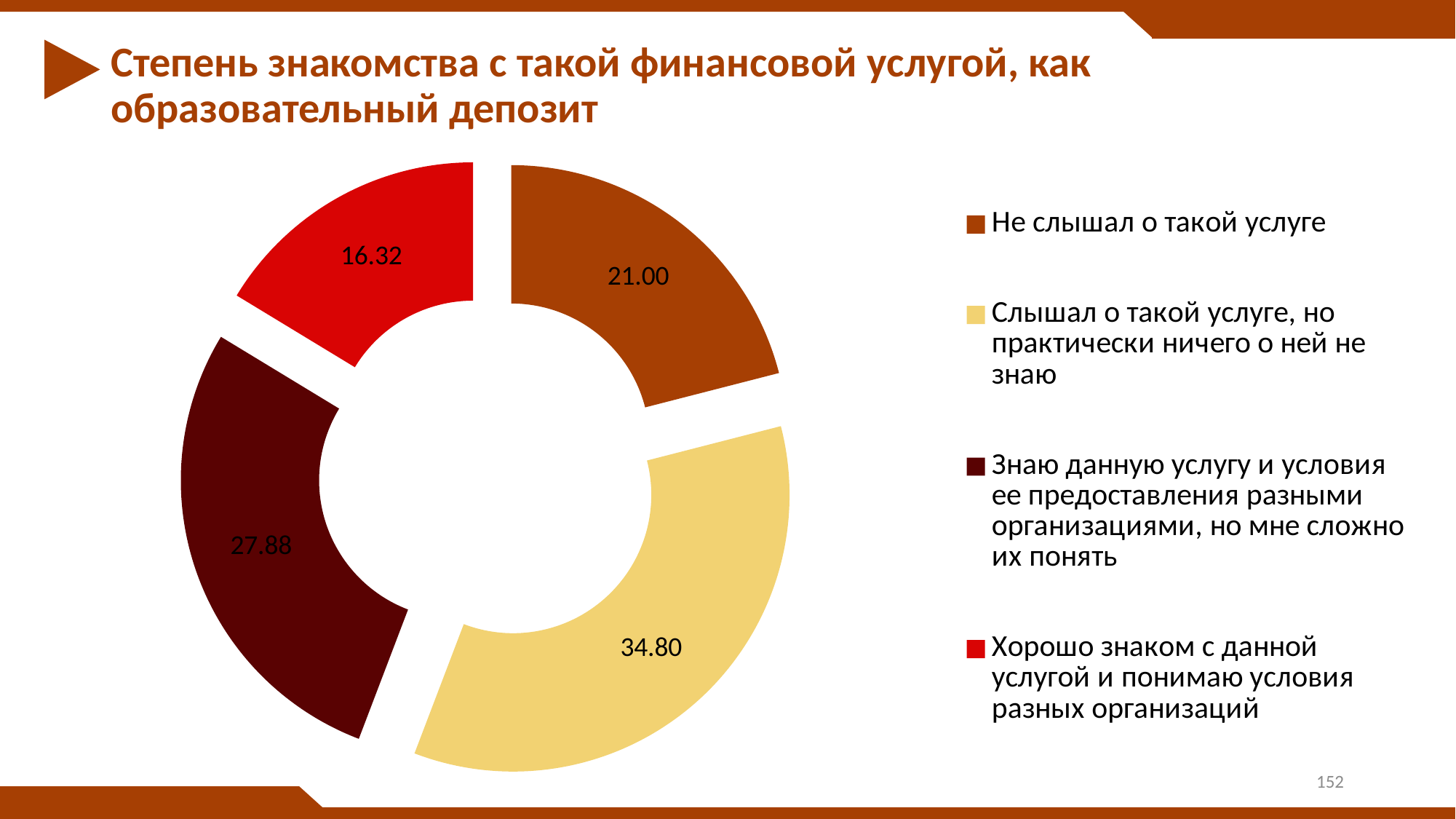
What kind of chart is shown on the slide? doughnut chart Which category has the largest slice? Слышал о такой услуге, но практически ничего о ней не знаю What is the total of all four slice values? 100.00 How many slices does the chart have? 4 Which is larger: the value for 'Не слышал о такой услуге' or the value for 'Хорошо знаком с данной услугой и понимаю условия разных организаций'? Не слышал о такой услуге What value is shown for the slice 'Слышал о такой услуге, но практически ничего о ней не знаю'? 34.80 What value is shown for the slice 'Хорошо знаком с данной услугой и понимаю условия разных организаций'? 16.32 What is the difference between the values for 'Слышал о такой услуге, но практически ничего о ней не знаю' and 'Не слышал о такой услуге'? 13.80 What value is shown for the slice 'Знаю данную услугу и условия ее предоставления разными организациями, но мне сложно их понять'? 27.88 Which category has the smallest slice? Хорошо знаком с данной услугой и понимаю условия разных организаций What value is shown for the slice 'Не слышал о такой услуге'? 21.00 What colour is the slice for 'Хорошо знаком с данной услугой и понимаю условия разных организаций'? red